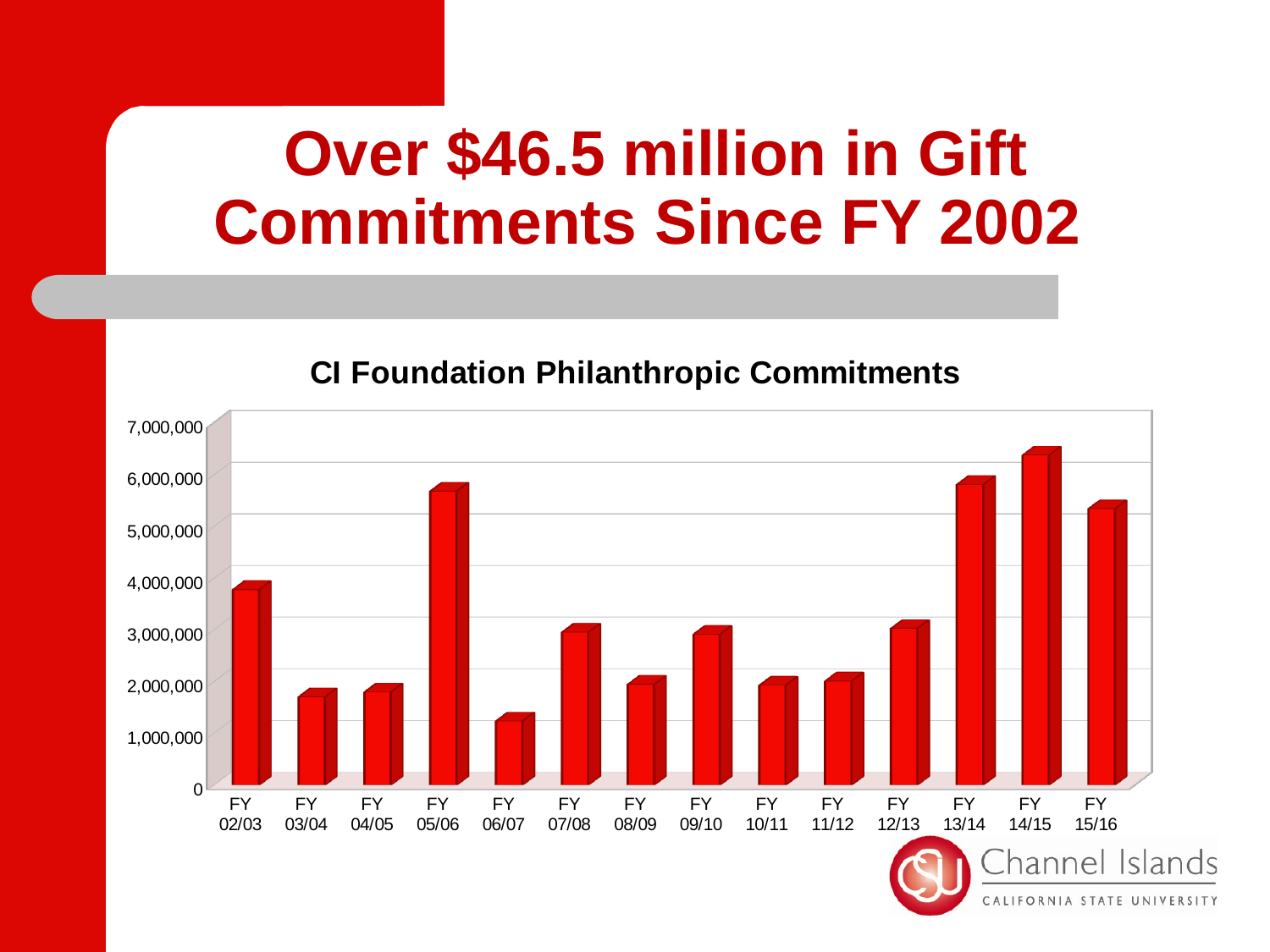
Is the value for FY 05/06 greater or less than 5,000,000? greater How many fiscal years are plotted in the chart? 14 What type of chart is shown on the slide? Bar chart Is the value for FY 14/15 greater or less than 6,000,000? greater Which is larger, the value for FY 05/06 or the value for FY 02/03? FY 05/06 Is the value for FY 06/07 greater or less than 2,000,000? less Which fiscal year has the highest philanthropic commitments? FY 14/15 Which fiscal year has the lowest philanthropic commitments? FY 06/07 What is the title of the chart? CI Foundation Philanthropic Commitments Do the values rise or fall from FY 12/13 to FY 14/15? rise